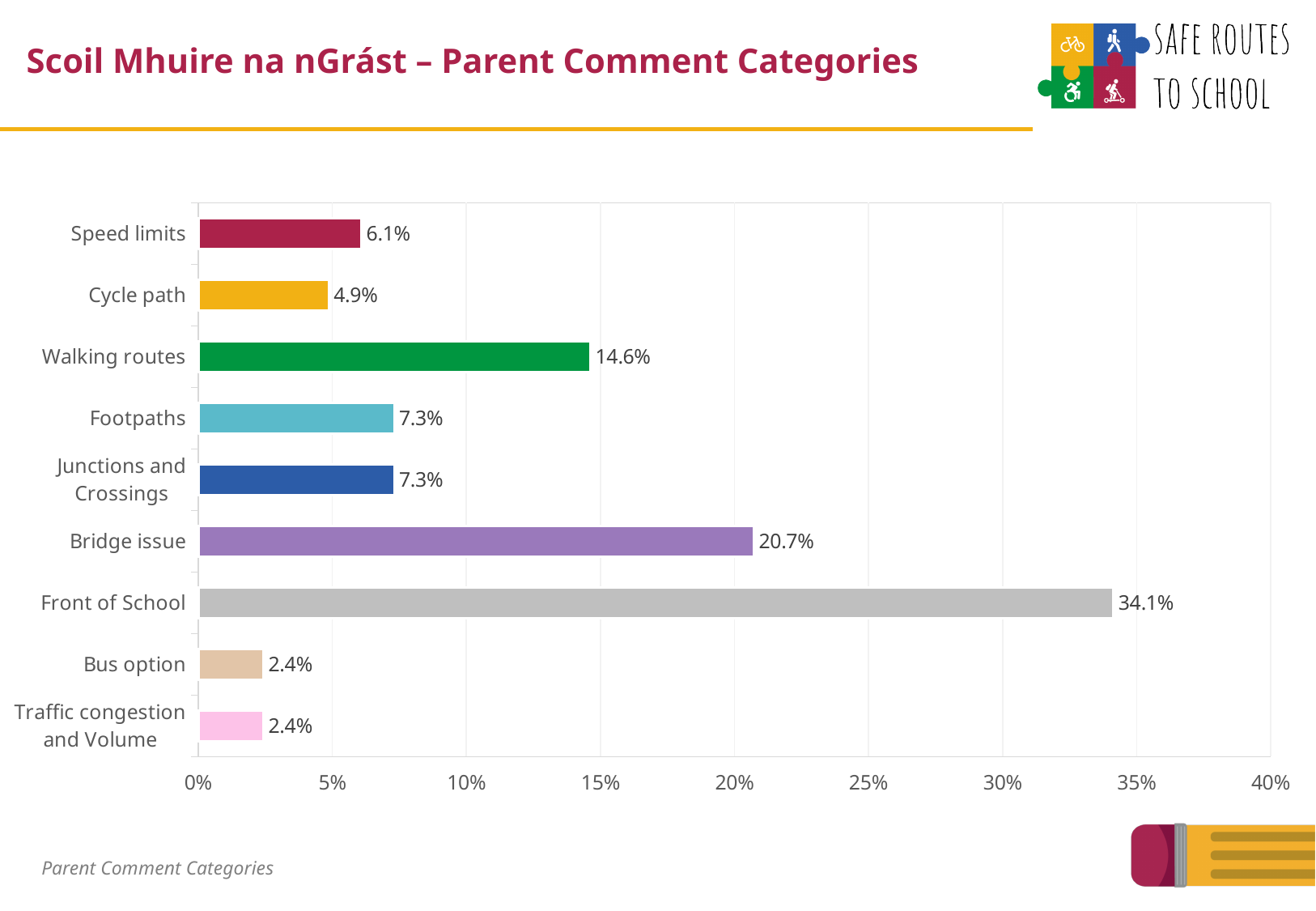
Is the value for Front of School greater or less than 30%? greater What is the value for Bridge issue? 20.7% Which category has the highest value? Front of School What is the difference between the values for Walking routes and Footpaths? 7.3 percentage points What is the value for Front of School? 34.1% What is the value for Cycle path? 4.9% How many categories are shown in the chart? 9 What kind of chart is shown on the slide? Bar chart Which is larger, the value for Speed limits or the value for Cycle path? Speed limits What is the difference between the values for Front of School and Bridge issue? 13.4 percentage points What is the highest value shown on the horizontal axis? 40% What is the value for Walking routes? 14.6%